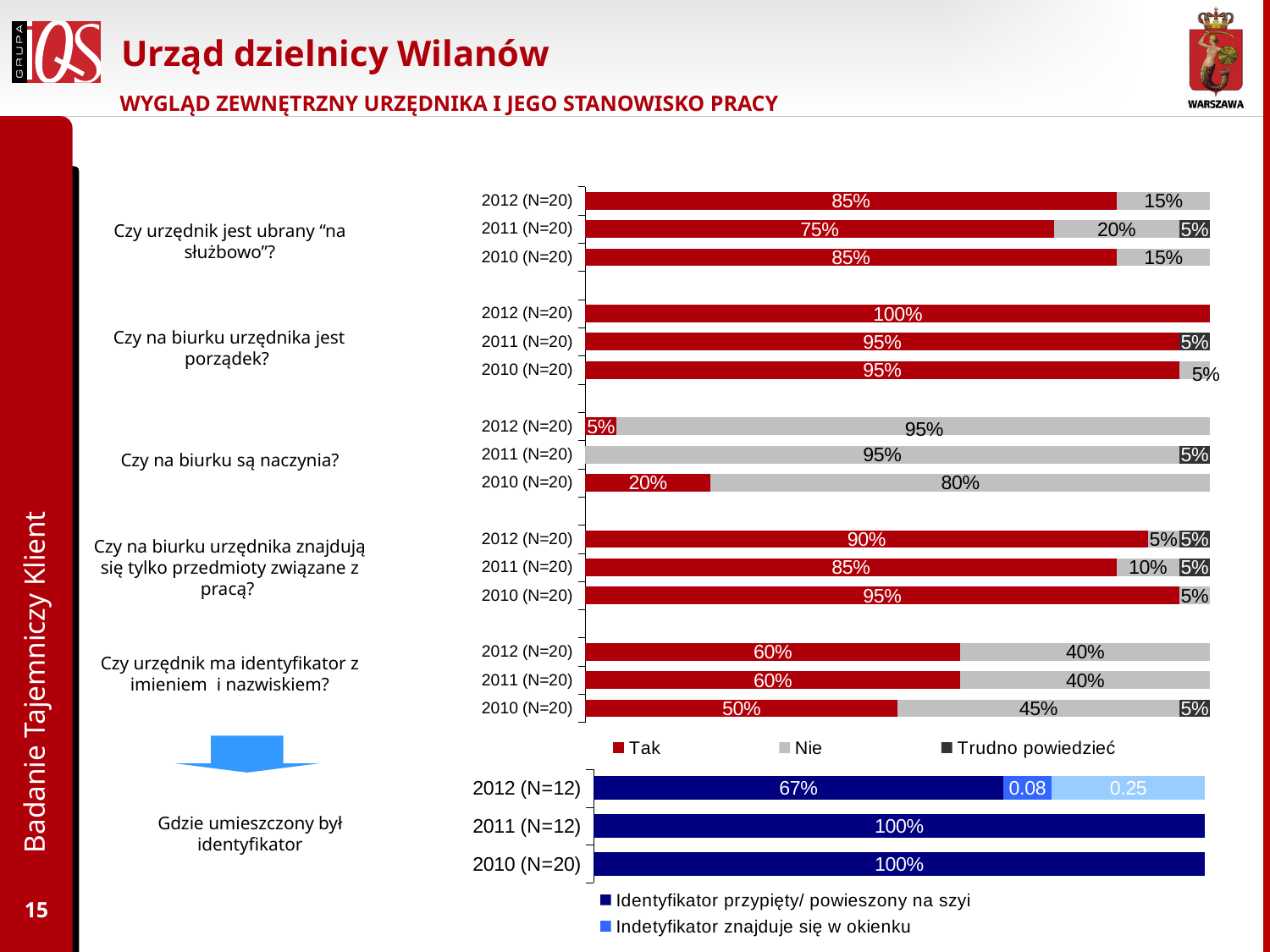
In the upper chart, for "Czy na biurku są naczynia?", which year has the highest "Tak" value? 2010 How many series does the legend of the upper chart list? 3 In the lower chart (Gdzie umieszczony był identyfikator), what is the value shown for 2011 (N=12)? 100% In the lower chart (Gdzie umieszczony był identyfikator), what is the value of the first segment for 2012 (N=12)? 67% In the upper chart, what is the "Nie" value for "Czy urzędnik jest ubrany 'na służbowo'?" in 2011 (N=20)? 20% In the upper chart, what percentage answered "Tak" to "Czy urzędnik jest ubrany 'na służbowo'?" in 2012 (N=20)? 85% In the upper chart, for "Czy na biurku urzędnika znajdują się tylko przedmioty związane z pracą?", which year has the higher "Tak" value, 2012 or 2011? 2012 What type of chart is the upper chart? Stacked bar chart In the upper chart, what is the "Tak" value for "Czy urzędnik ma identyfikator z imieniem i nazwiskiem?" in 2010 (N=20)? 50% In the upper chart, what is the "Nie" value for "Czy na biurku są naczynia?" in 2010 (N=20)? 80% In the upper chart, what is the "Tak" value for "Czy na biurku urzędnika jest porządek?" in 2012 (N=20)? 100% In the upper chart, for "Czy urzędnik ma identyfikator z imieniem i nazwiskiem?", what is the difference between the "Tak" value in 2012 and in 2010? 10%